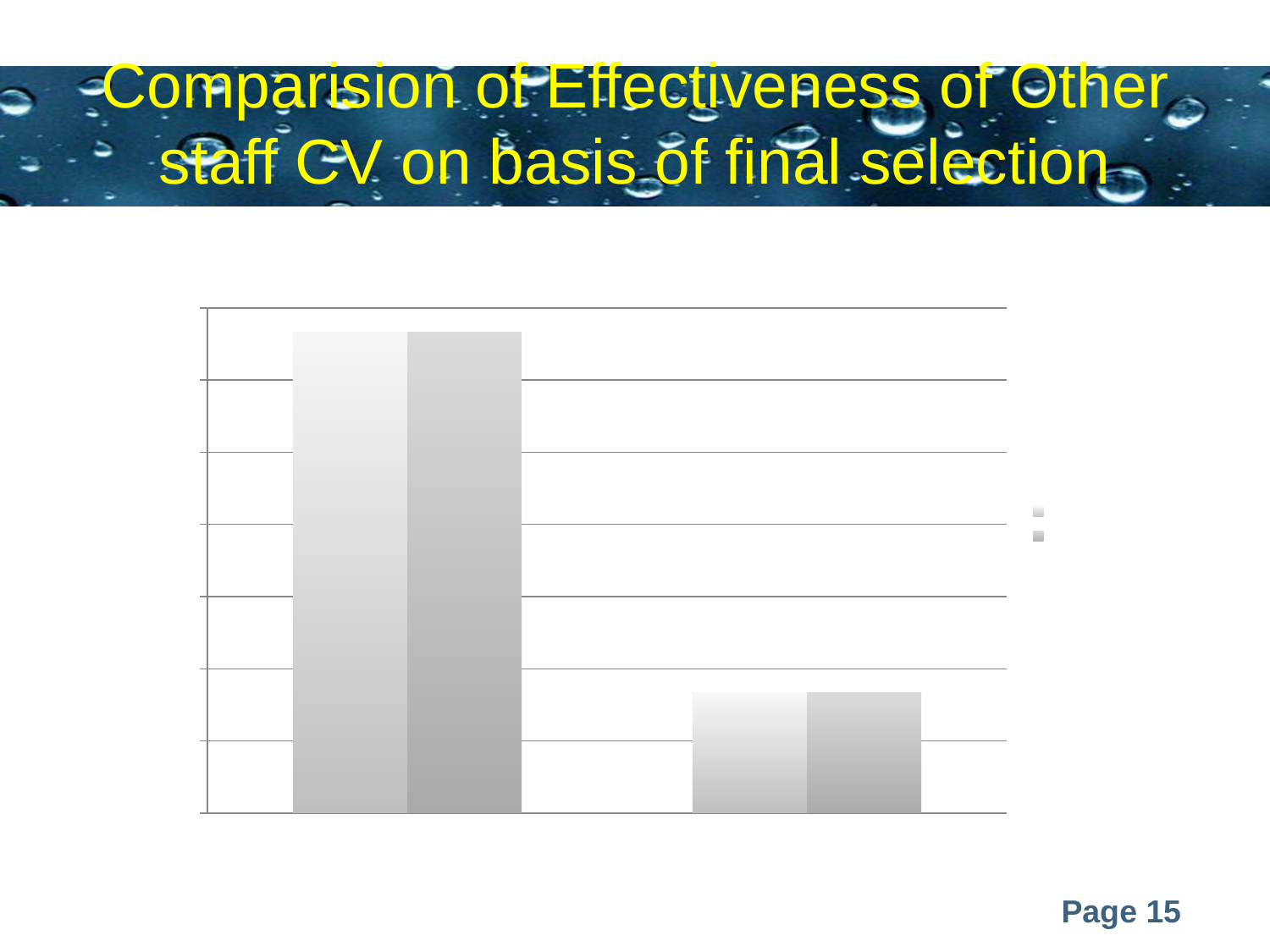
How many bars are plotted in the chart in total? 4 How many series does the chart's legend list? 2 What is the title of the slide containing the chart? Comparision of Effectiveness of Other staff CV on basis of final selection How many category groups of bars does the chart show? 2 Are the bars in the chart vertical or horizontal? vertical Which group of bars is taller, the left group or the right group? the left group What kind of chart is shown on the slide? bar chart Do the bar heights rise or fall from left to right across the chart? fall